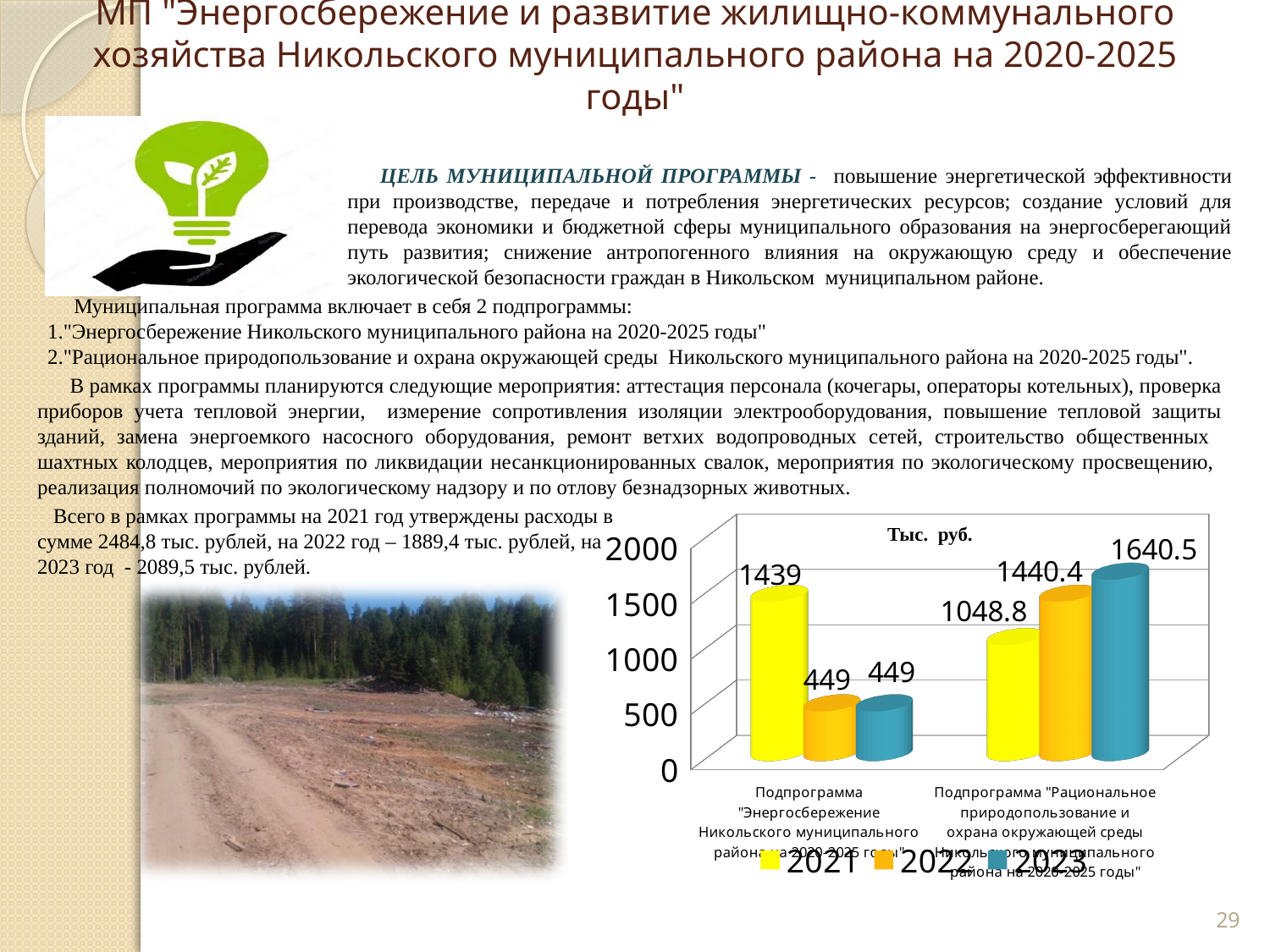
Which year has the highest value for the subprogramme "Рациональное природопользование и охрана окружающей среды"? 2023 What is the title of the chart? Тыс. руб. What is the 2022 value for the subprogramme "Энергосбережение Никольского муниципального района на 2020-2025 годы"? 449 What is the 2021 value for the subprogramme "Энергосбережение Никольского муниципального района на 2020-2025 годы"? 1439 Do the values for the subprogramme "Рациональное природопользование и охрана окружающей среды" rise or fall from 2021 to 2023? rise What type of chart is shown on the slide? bar chart What is the difference between the 2023 and 2021 values for the subprogramme "Рациональное природопользование и охрана окружающей среды"? 591.7 How many categories (subprogrammes) are shown on the x axis of the chart? 2 Which year has the lowest value for the subprogramme "Рациональное природопользование и охрана окружающей среды"? 2021 Which is larger: the 2021 value for the "Энергосбережение" subprogramme or the 2021 value for the "Рациональное природопользование" subprogramme? Энергосбережение (1439) What is the 2023 value for the subprogramme "Рациональное природопользование и охрана окружающей среды Никольского муниципального района на 2020-2025 годы"? 1640.5 How many series does the chart legend list? 3